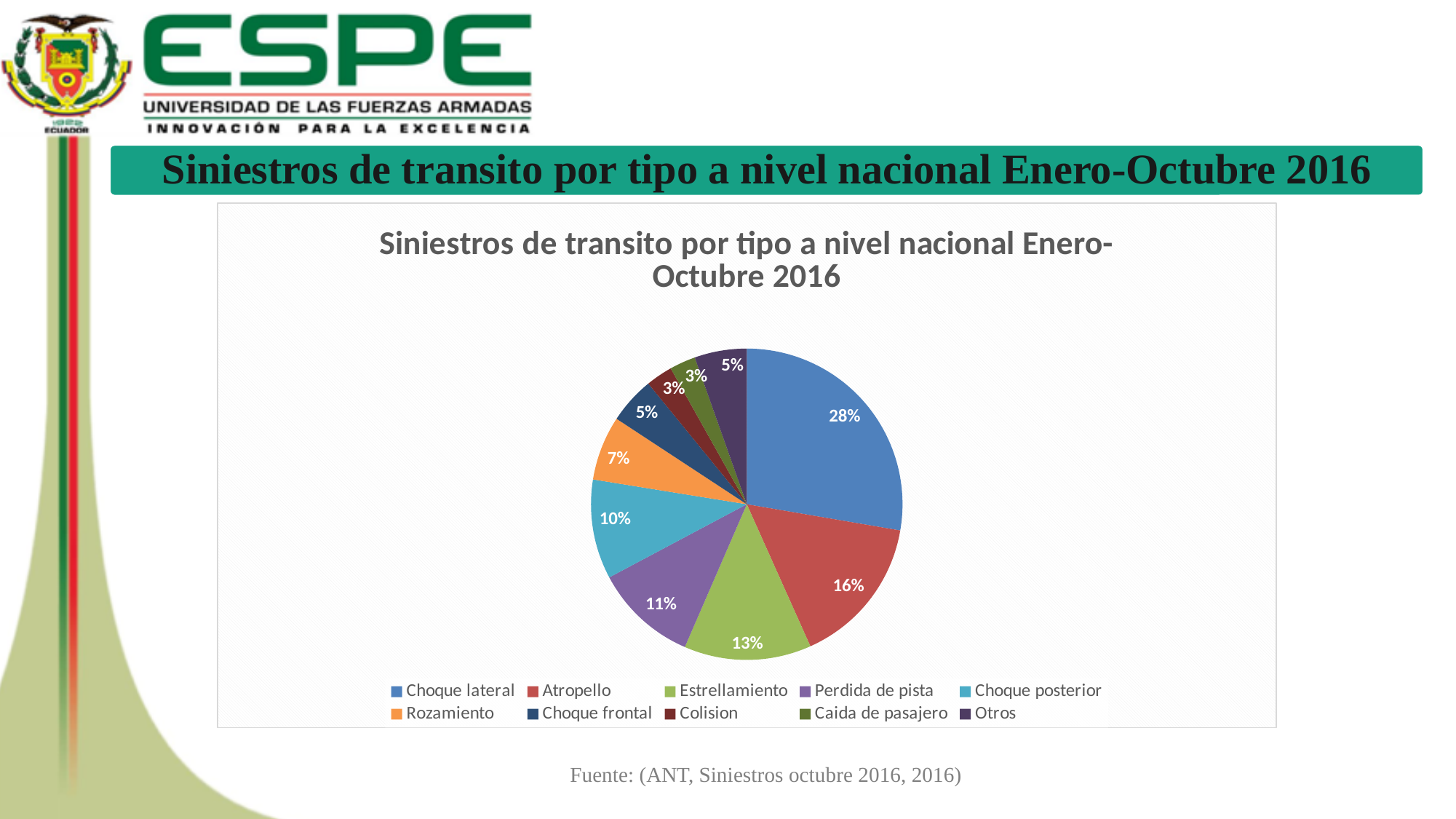
What kind of chart is shown on the slide? Pie chart Which is larger, Perdida de pista or Choque posterior? Perdida de pista What share of the pie does Choque lateral have? 28% What percentage is shown for Atropello? 16% What is the title of the chart? Siniestros de transito por tipo a nivel nacional Enero-Octubre 2016 How many categories does the legend list? 10 What percentage is shown for Choque posterior? 10% What is the combined share of Choque frontal and Otros? 10% What is the difference in percentage points between Choque lateral and Atropello? 12 Which category has the largest slice of the pie? Choque lateral What percentage is shown for Estrellamiento? 13% What percentage is shown for Rozamiento? 7%